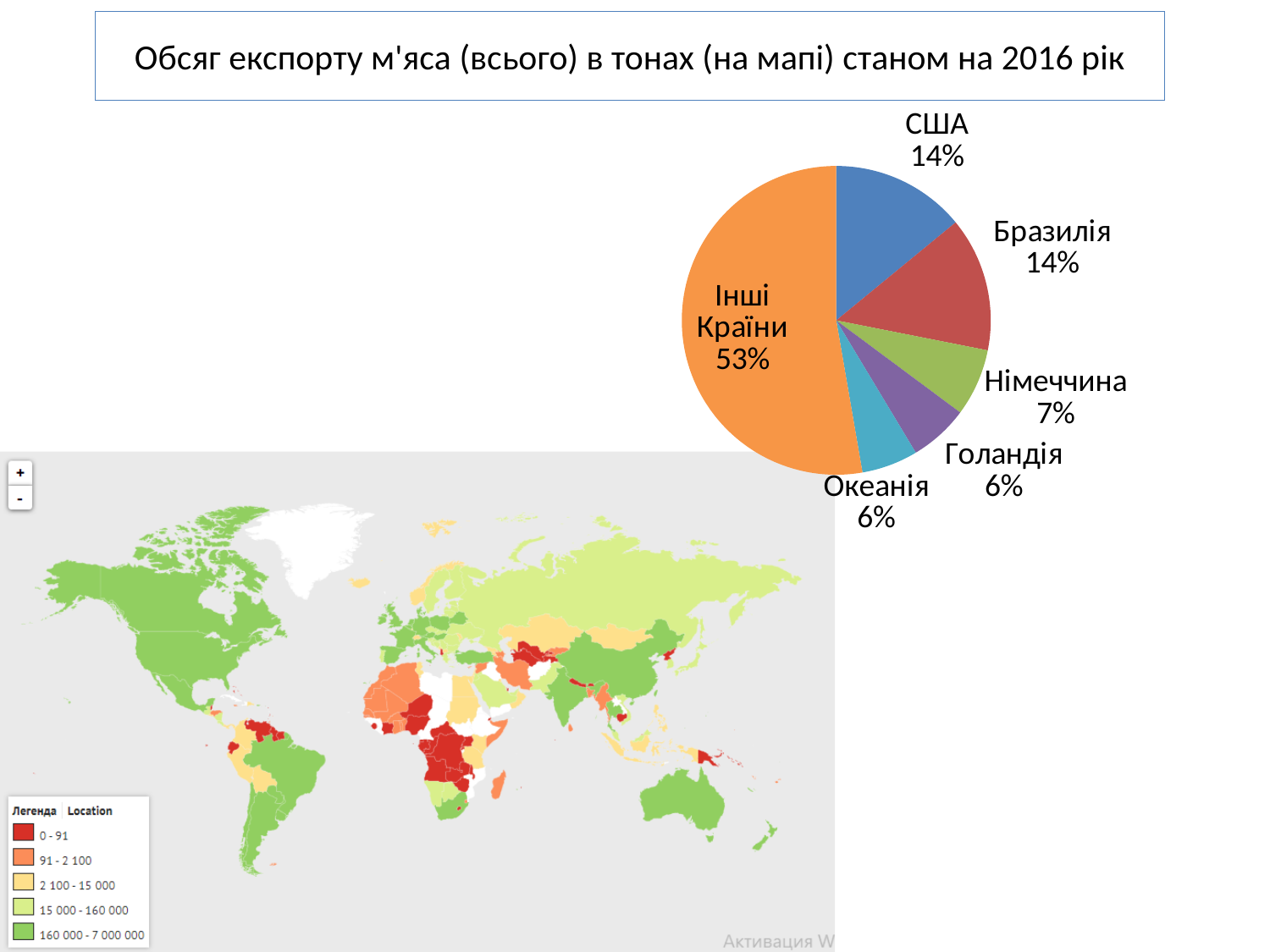
What is the title of the slide? Обсяг експорту м'яса (всього) в тонах (на мапі) станом на 2016 рік In the pie chart, what is the difference between the share for Інші Країни and the share for США? 39% In the pie chart, what share does Бразилія have? 14% In the pie chart, which slice is the largest? Інші Країни What kind of chart is shown in the upper right of the slide? pie chart In the pie chart, what share does Інші Країни have? 53% In the pie chart, what share does Німеччина have? 7% How many slices does the pie chart have? 6 In the pie chart, what share does Океанія have? 6% In the pie chart, which is larger: the share for США or the share for Німеччина? США In the pie chart, what share does США have? 14% In the pie chart, what share does Голандія have? 6%